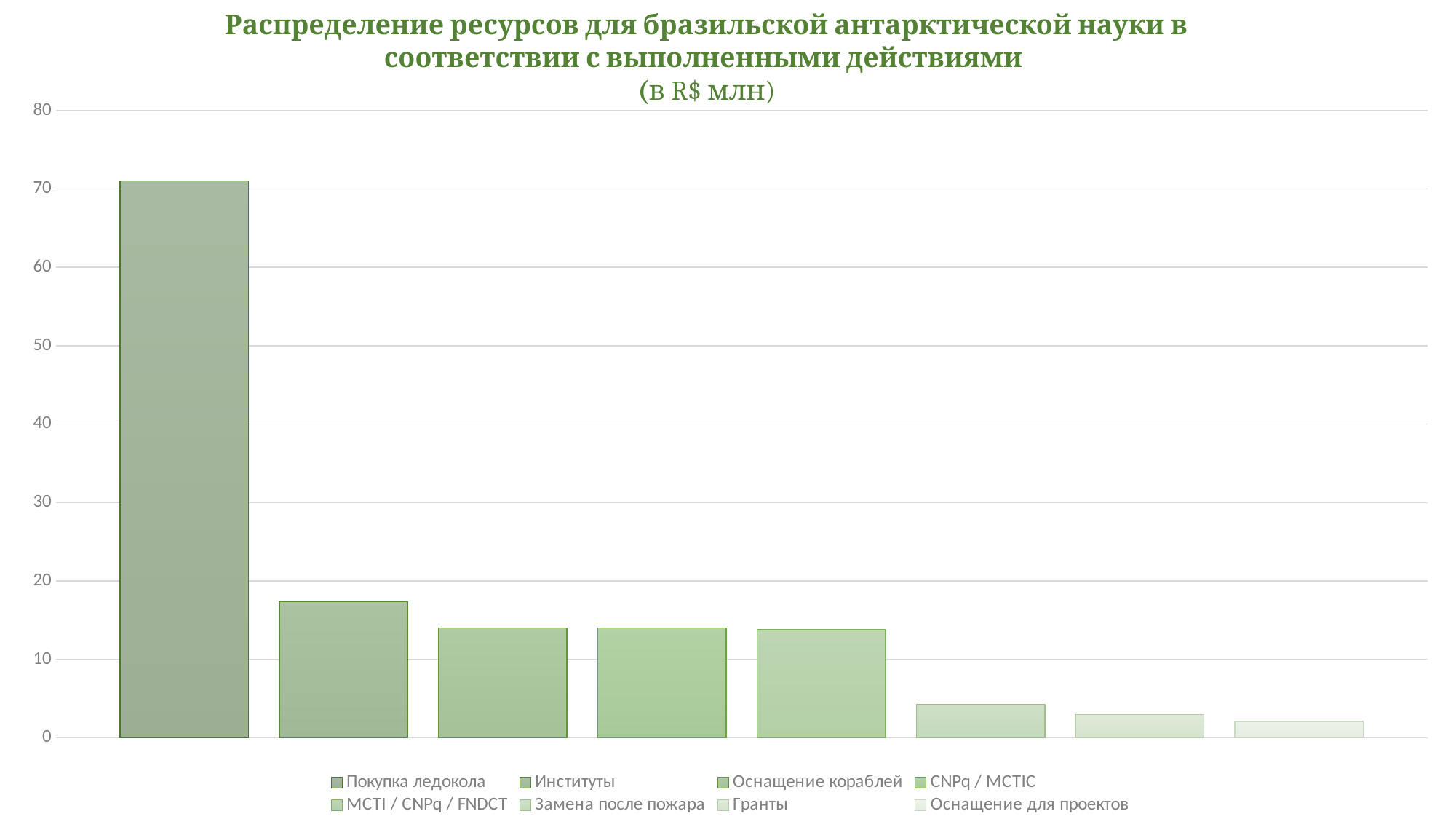
Is the value for Институты greater or less than 20? less Is the value for Покупка ледокола greater or less than 60? greater Which is larger, the value for Покупка ледокола or the value for Институты? Покупка ледокола Do the bar values rise or fall from left to right across the chart? fall Which category has the highest value? Покупка ледокола Which category has the lowest value? Оснащение для проектов Is the value for Гранты greater or less than 10? less In what unit are the values in the chart expressed, according to the title? R$ млн Which is larger, the value for Институты or the value for Оснащение кораблей? Институты How many entries does the legend list? 8 What kind of chart is shown on the slide? bar chart How many bars are plotted in the chart? 8